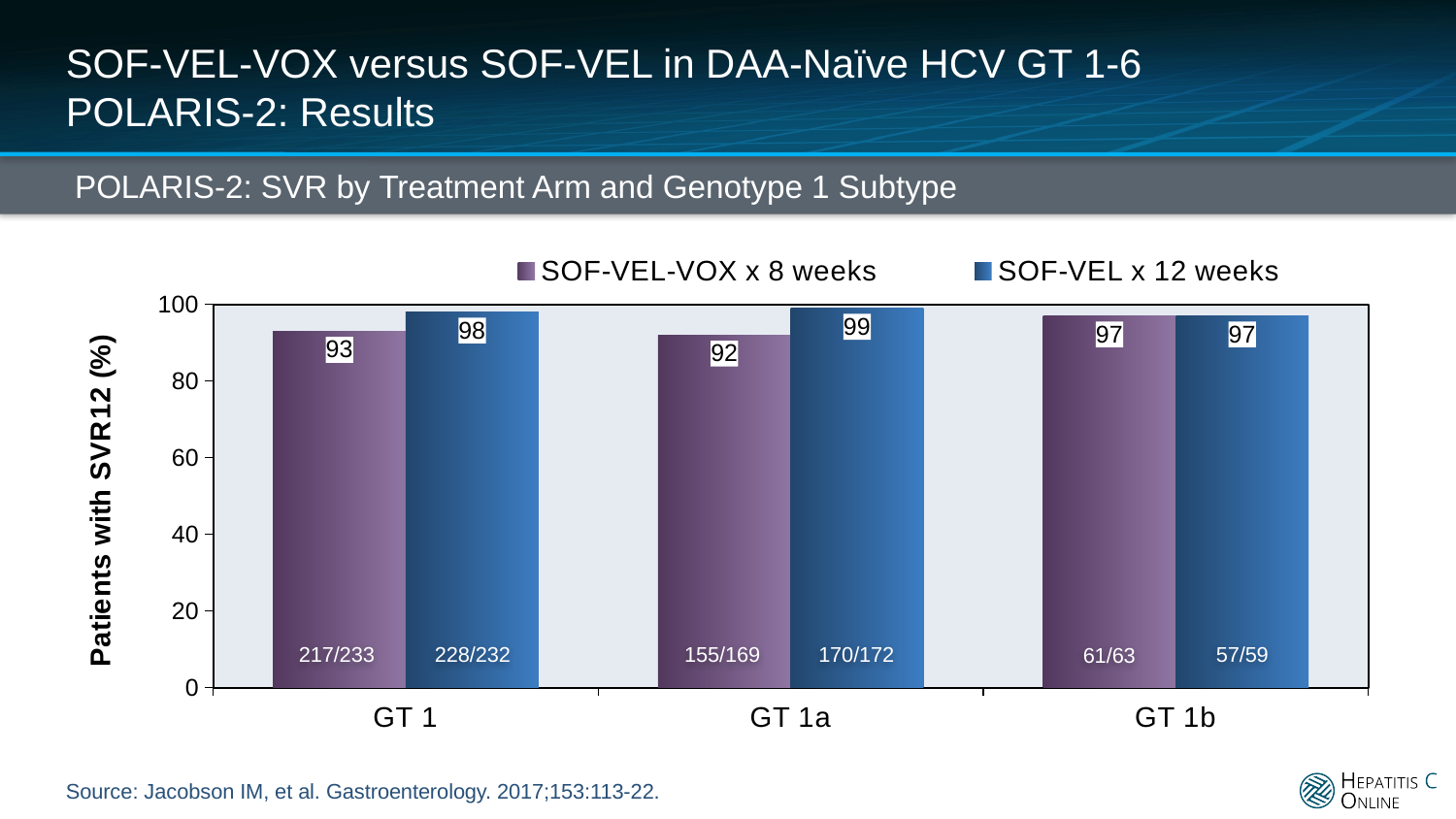
How many series does the legend list? 2 How many genotype subtype categories are shown on the x axis? 3 What fraction of patients is shown for SOF-VEL x 12 weeks in GT 1? 228/232 What fraction of patients is shown for SOF-VEL-VOX x 8 weeks in GT 1a? 155/169 What kind of chart is shown on the slide? Bar chart What is the SVR12 rate for SOF-VEL-VOX x 8 weeks in GT 1? 93 What is the difference in SVR12 rate between SOF-VEL x 12 weeks and SOF-VEL-VOX x 8 weeks in GT 1a? 7 Which treatment arm has the higher SVR12 rate in GT 1? SOF-VEL x 12 weeks What is the SVR12 rate for SOF-VEL-VOX x 8 weeks in GT 1b? 97 What is the SVR12 rate for SOF-VEL x 12 weeks in GT 1a? 99 Which genotype subtype has the lowest SVR12 rate for SOF-VEL-VOX x 8 weeks? GT 1a Which genotype subtype has the highest SVR12 rate for SOF-VEL x 12 weeks? GT 1a